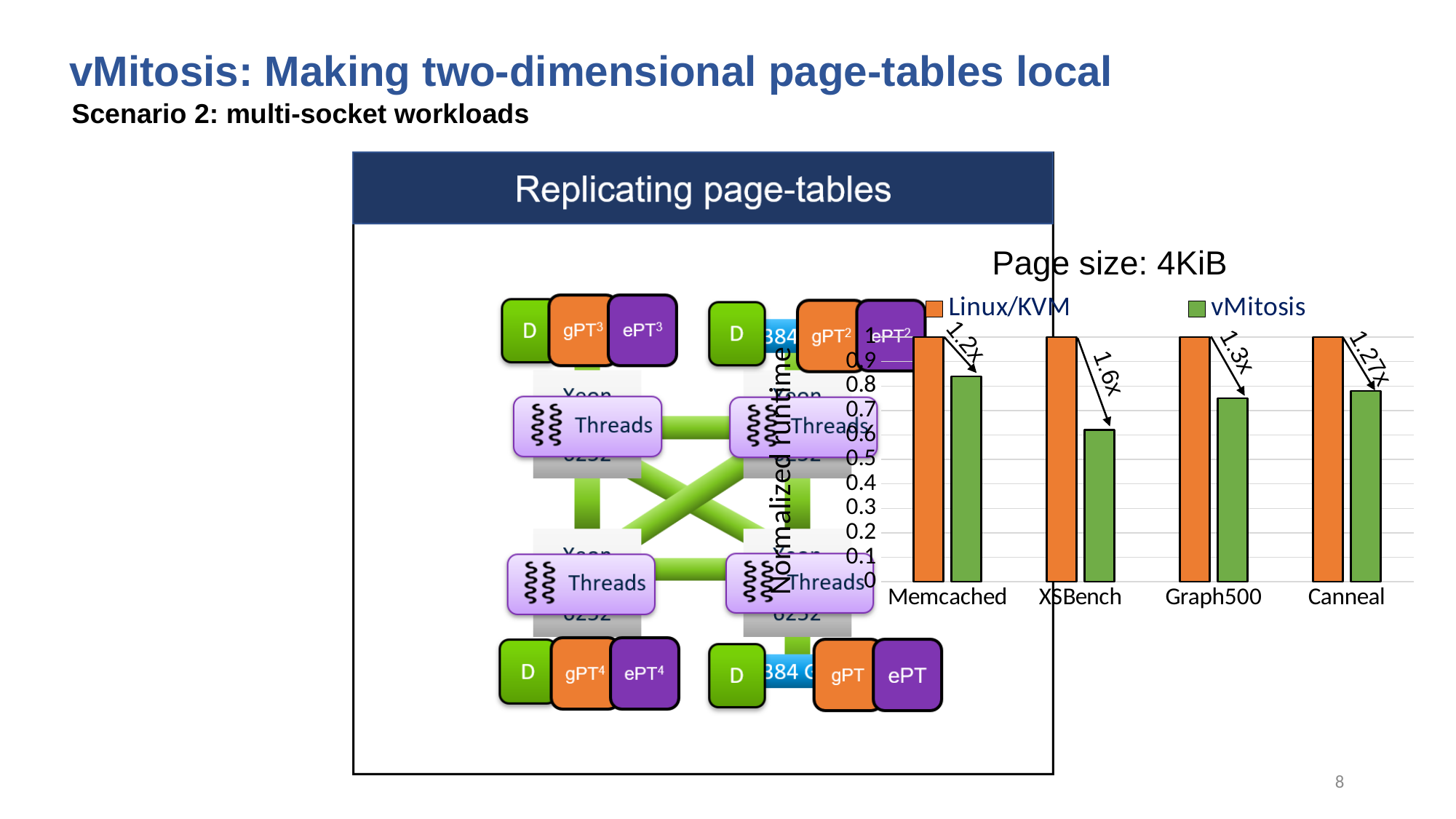
What is the label of the chart's y axis? Normalized runtime Is the vMitosis normalized runtime for Memcached greater or less than 0.7? greater What speedup is annotated for XSBench in the chart? 1.6x Is the vMitosis normalized runtime for XSBench greater or less than 0.7? less What speedup is annotated for Graph500 in the chart? 1.3x What kind of chart is shown on the slide? bar chart Which workload has the lowest vMitosis normalized runtime? XSBench How many workloads (categories) are shown on the x axis of the chart? 4 For Graph500, which series has the larger normalized runtime, Linux/KVM or vMitosis? Linux/KVM What speedup is annotated for Memcached in the chart? 1.2x How many series does the chart's legend list? 2 What speedup is annotated for Canneal in the chart? 1.27x